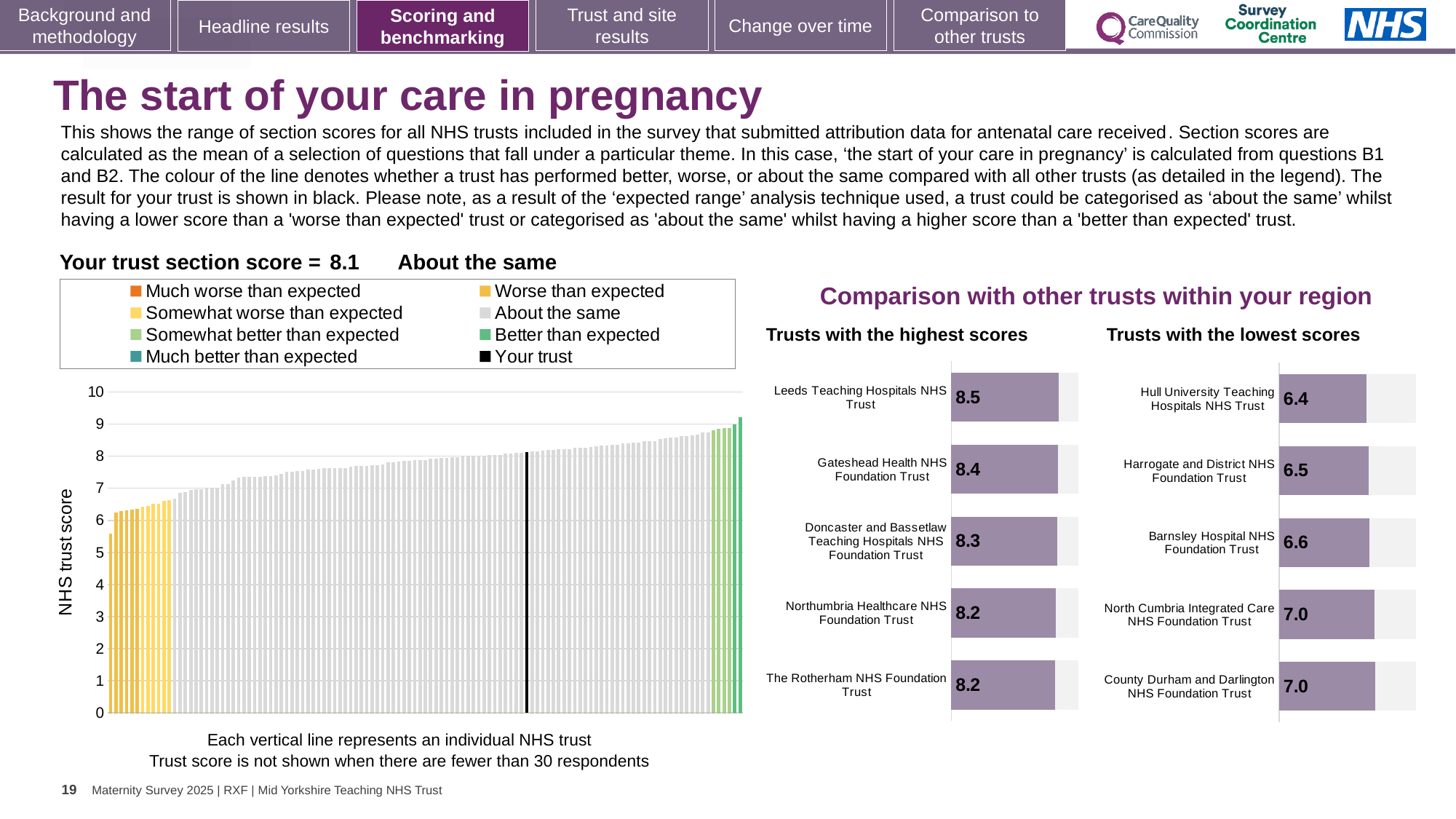
What is the section score for your trust shown on the main chart? 8.1 In the 'Trusts with the highest scores' chart, what is the difference between the scores of Leeds Teaching Hospitals NHS Trust and Northumbria Healthcare NHS Foundation Trust? 0.3 In the 'Trusts with the lowest scores' chart, what is the difference between the scores of County Durham and Darlington NHS Foundation Trust and Hull University Teaching Hospitals NHS Trust? 0.6 In the main chart of NHS trust scores, do the values rise or fall from left to right? Rise How many entries does the legend of the main chart list? 8 In the 'Trusts with the highest scores' chart, which trust has the highest score? Leeds Teaching Hospitals NHS Trust How many trusts are shown in the 'Trusts with the highest scores' chart? 5 In the 'Trusts with the highest scores' chart, what is the score for Leeds Teaching Hospitals NHS Trust? 8.5 In the 'Trusts with the lowest scores' chart, which has the larger score: Harrogate and District NHS Foundation Trust or Barnsley Hospital NHS Foundation Trust? Barnsley Hospital NHS Foundation Trust What kind of chart is the main chart showing NHS trust scores? Bar chart In the 'Trusts with the lowest scores' chart, what is the score for Hull University Teaching Hospitals NHS Trust? 6.4 In the 'Trusts with the lowest scores' chart, which trust has the lowest score? Hull University Teaching Hospitals NHS Trust